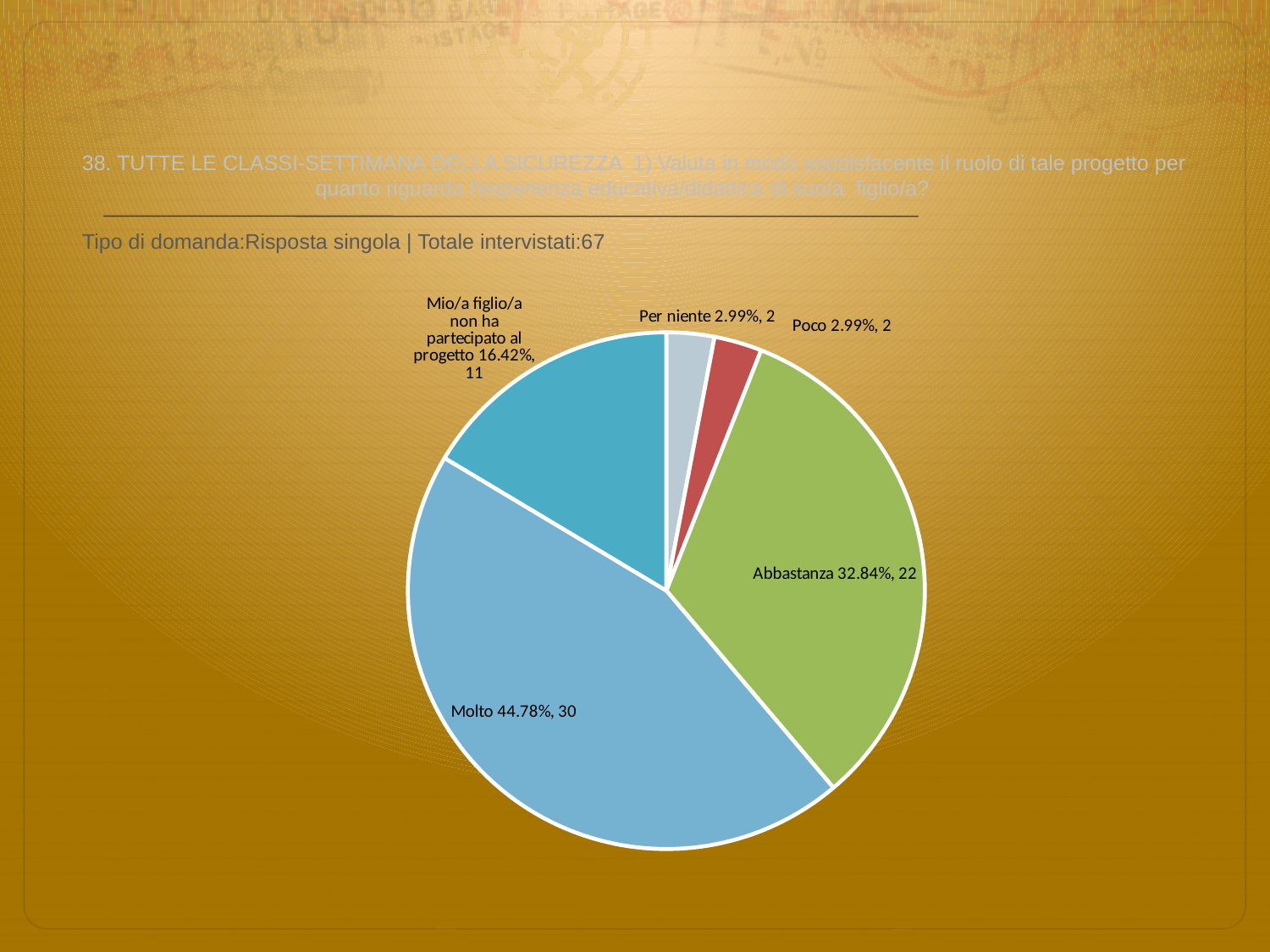
How many respondents answered "Mio/a figlio/a non ha partecipato al progetto"? 11 What percentage share does the "Molto" slice have? 44.78% What is the difference in respondent count between "Molto" and "Abbastanza"? 8 Which category has the largest slice? Molto How many slices does the pie chart have? 5 Which is larger, the "Abbastanza" slice or the "Mio/a figlio/a non ha partecipato al progetto" slice? Abbastanza What colour is the "Molto" slice? light blue What kind of chart is shown on the slide? pie chart What percentage share does the "Poco" slice have? 2.99% What percentage share does the "Abbastanza" slice have? 32.84% What is the total number of respondents stated on the slide? 67 How many respondents answered "Abbastanza"? 22